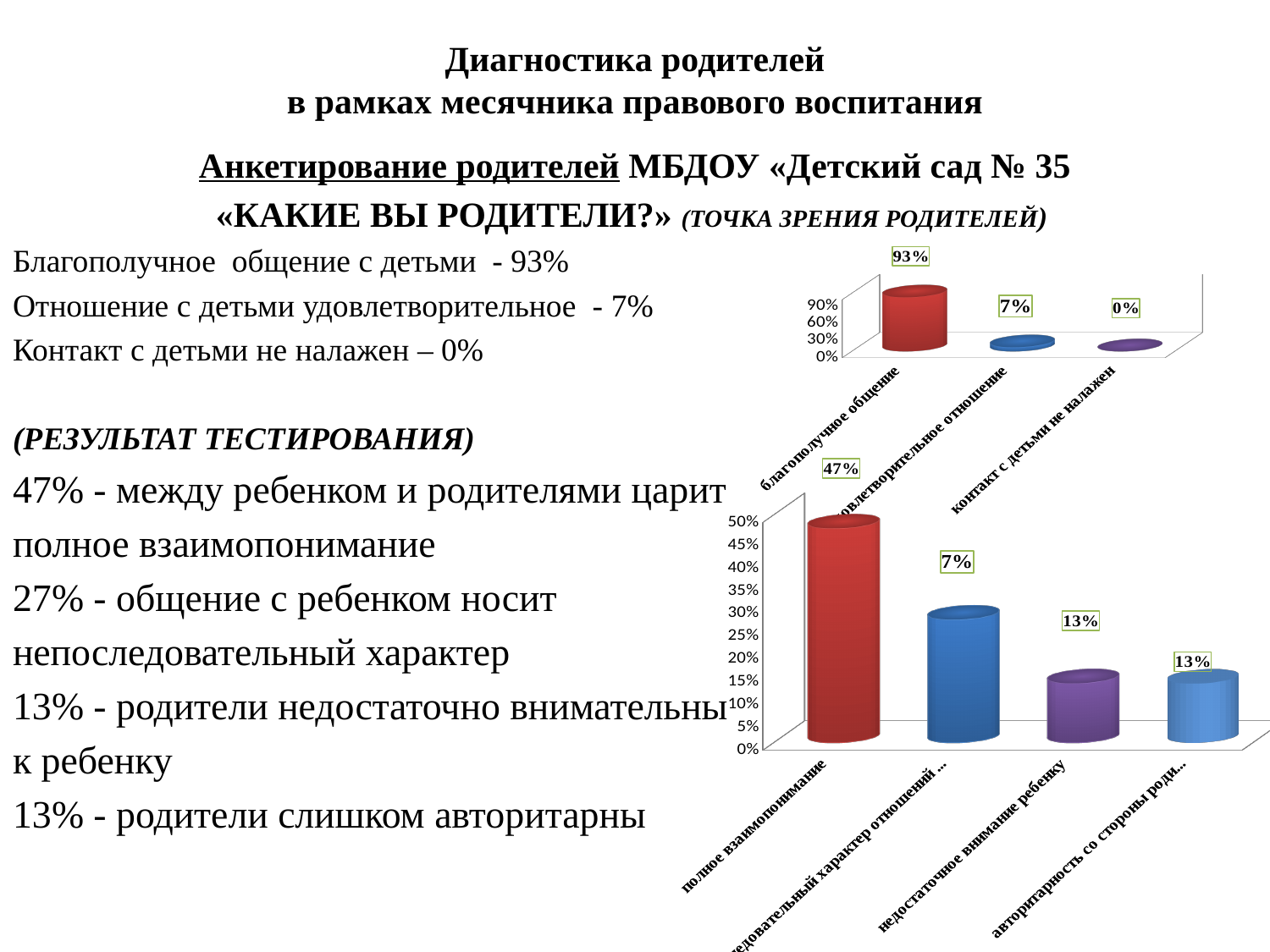
In the top-right chart, what is the value for «благополучное общение»? 93% How many categories are shown in the top-right chart? 3 In the top-right chart, which category has the lowest value? контакт с детьми не налажен How many bars are shown in the bottom-right chart? 4 What kind of chart is the top-right chart? bar chart In the bottom-right chart, which category has the highest value? полное взаимопонимание In the bottom-right chart, which is larger: the value for «полное взаимопонимание» or the value for «недостаточное внимание ребенку»? полное взаимопонимание In the bottom-right chart, what is the value for «недостаточное внимание ребенку»? 13% In the top-right chart, what is the difference between the values for «благополучное общение» and «удовлетворительное отношение»? 86 percentage points In the top-right chart, what is the value for «контакт с детьми не налажен»? 0% In the bottom-right chart, what is the value for «полное взаимопонимание»? 47% In the top-right chart, which category has the highest value? благополучное общение